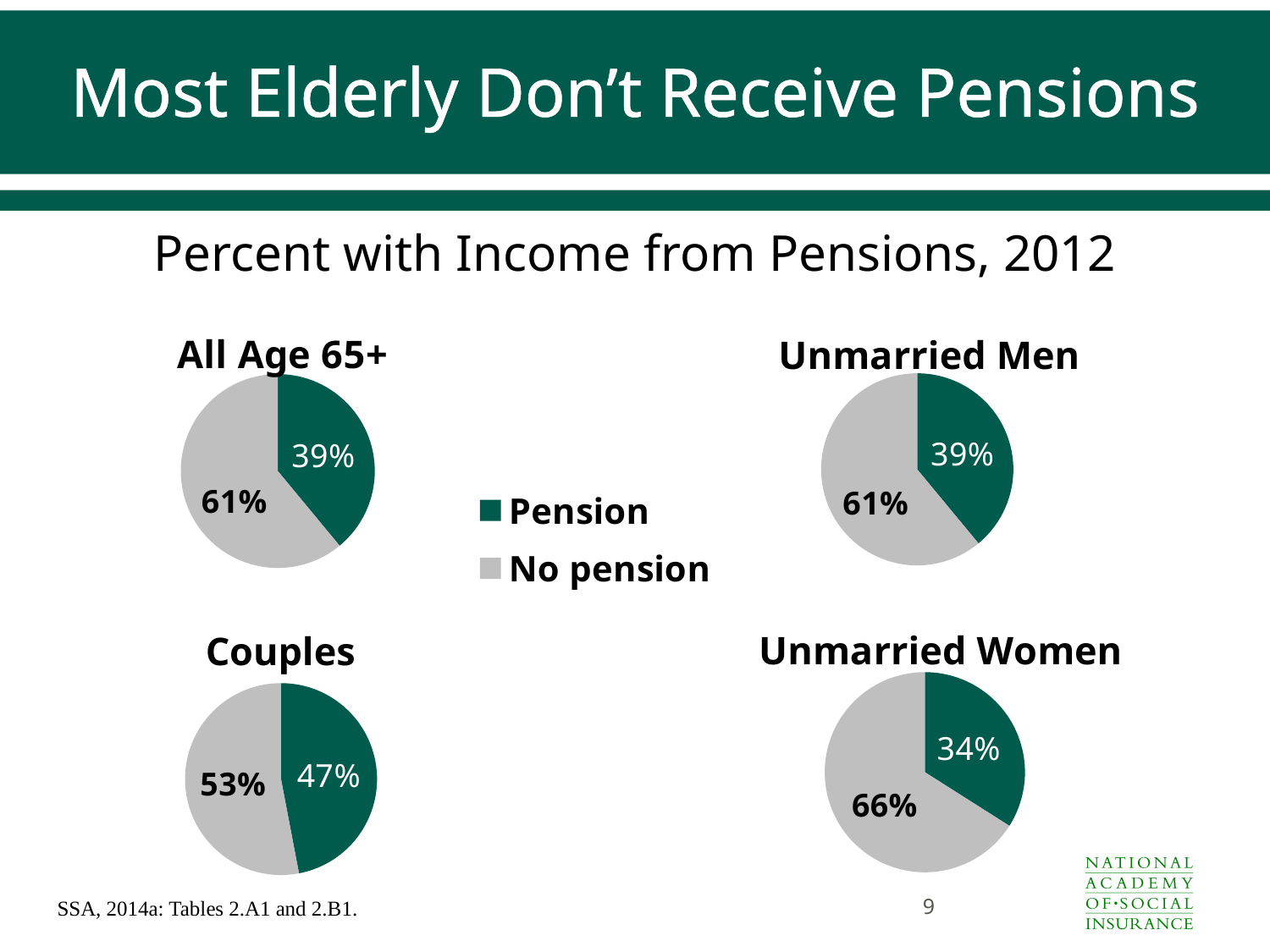
Which colour represents 'No pension' in the legend? Gray Across the four pie charts, which group has the highest share with a pension? Couples What is the difference between the 'No pension' share for Unmarried Women and the 'No pension' share for Couples? 13% How many series does the legend list? 2 What kind of chart is used on this slide? Pie chart Is the 'Pension' share larger for Couples or for Unmarried Men? Couples In the 'Unmarried Women' pie chart, what percentage has no pension? 66% In the 'Couples' pie chart, what percentage has a pension? 47% How many pie charts are on the slide? 4 Across the four pie charts, which group has the lowest share with a pension? Unmarried Women In the 'Unmarried Men' pie chart, what percentage has no pension? 61% In the 'All Age 65+' pie chart, what percentage has a pension? 39%